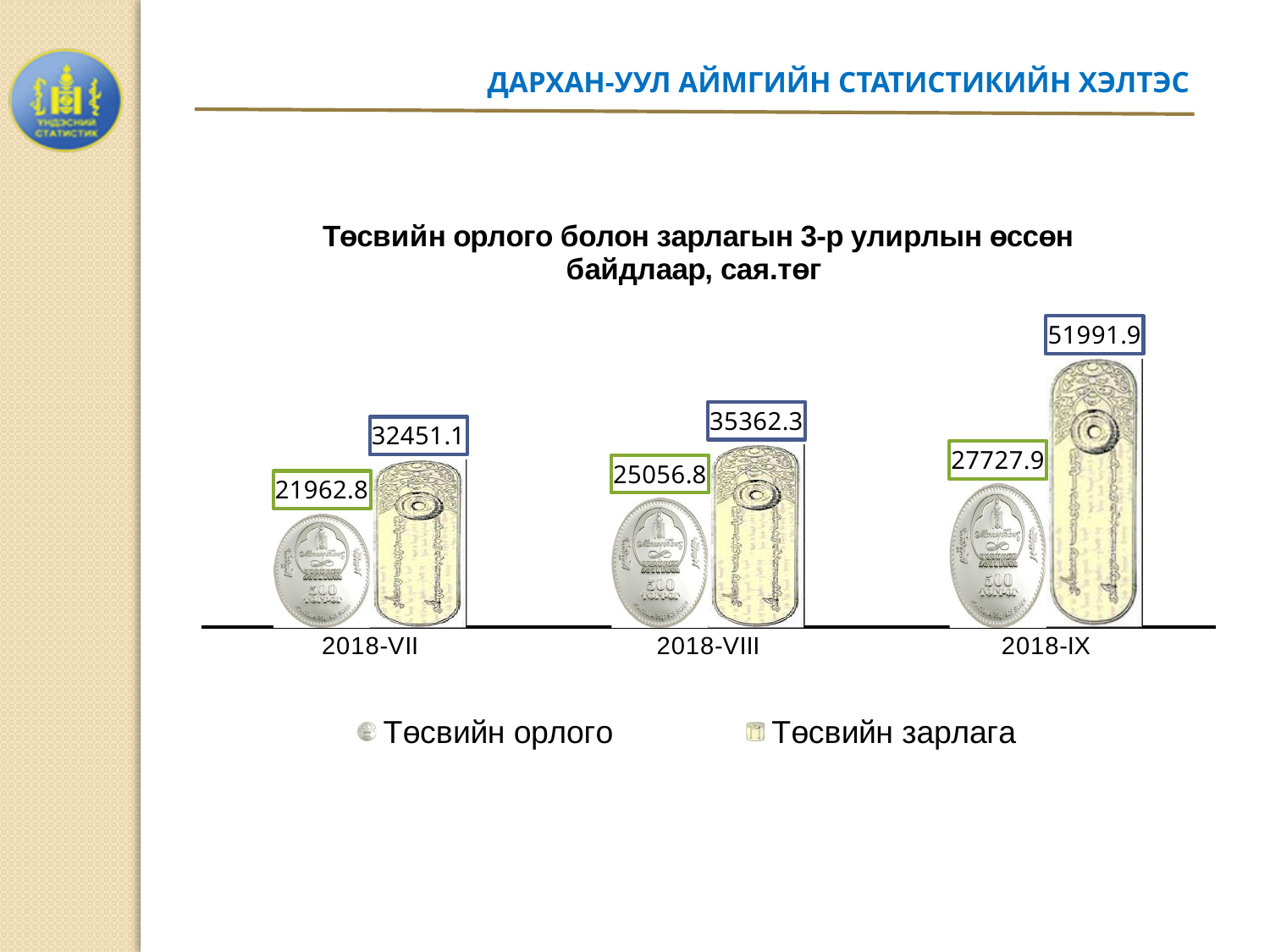
What is the value of Төсвийн орлого for 2018-VIII? 25056.8 What is the difference between Төсвийн зарлага and Төсвийн орлого in 2018-VII? 10488.3 In which month is Төсвийн орлого lowest? 2018-VII How many series does the legend list? 2 What is the difference between Төсвийн зарлага and Төсвийн орлого in 2018-IX? 24264.0 Which is larger in 2018-VIII, Төсвийн орлого or Төсвийн зарлага? Төсвийн зарлага What is the value of Төсвийн зарлага for 2018-VIII? 35362.3 What is the value of Төсвийн орлого for 2018-VII? 21962.8 In which month is Төсвийн зарлага highest? 2018-IX How many months are shown on the x axis? 3 What is the value of Төсвийн зарлага for 2018-IX? 51991.9 Does Төсвийн орлого rise or fall from 2018-VII to 2018-IX? rise